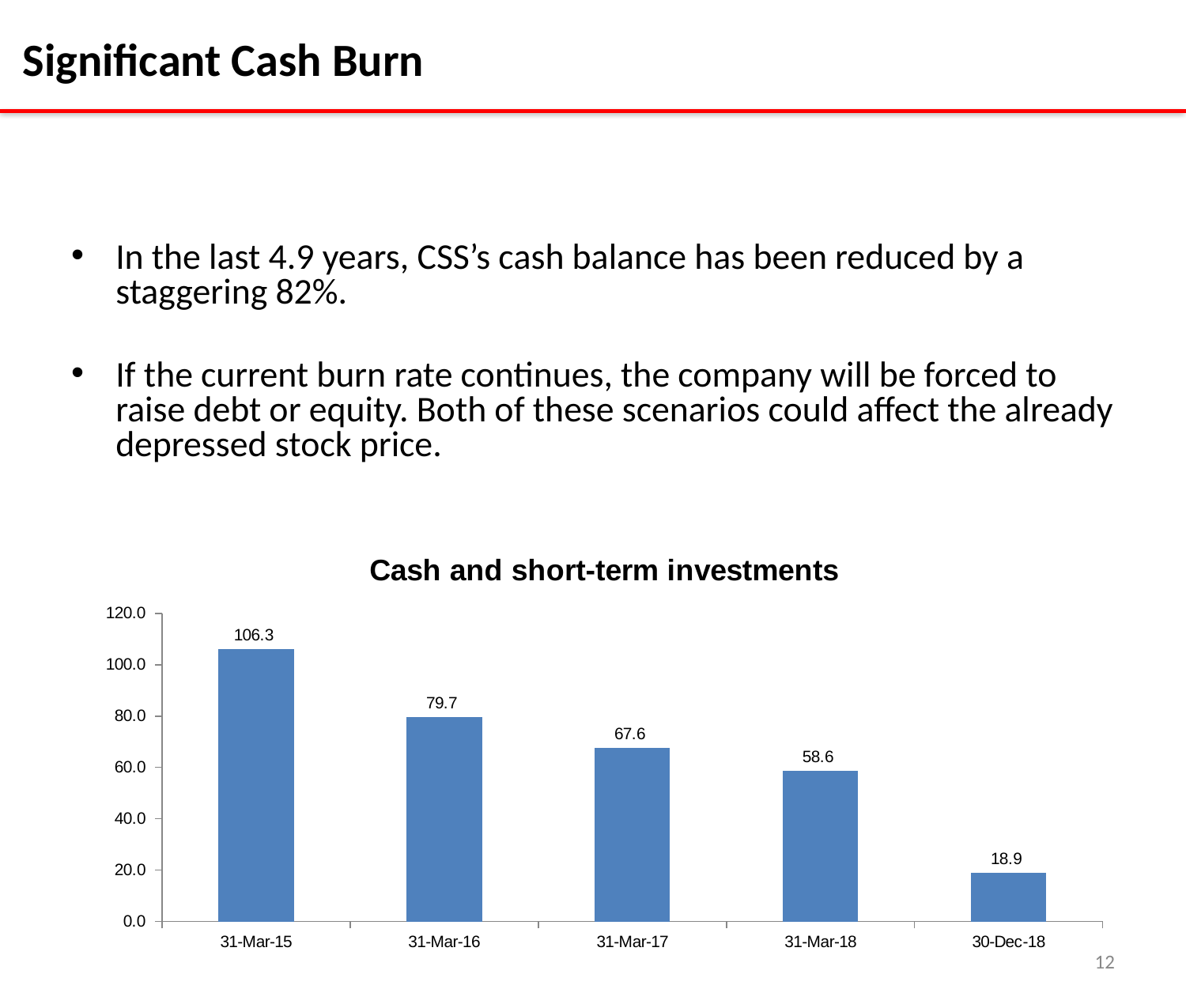
What is the value for 31-Mar-17? 67.6 Which is larger, the value for 31-Mar-16 or the value for 31-Mar-18? 31-Mar-16 Which date has the lowest value? 30-Dec-18 How many dates are shown on the x axis? 5 What is the difference between the values for 31-Mar-15 and 30-Dec-18? 87.4 What kind of chart is shown? bar chart What is the value for 30-Dec-18? 18.9 Do the values rise or fall from 31-Mar-15 to 30-Dec-18? fall Is the value for 31-Mar-18 greater or less than 60.0? less What is the difference between the values for 31-Mar-16 and 31-Mar-17? 12.1 What is the value for 31-Mar-15? 106.3 Which date has the highest value? 31-Mar-15